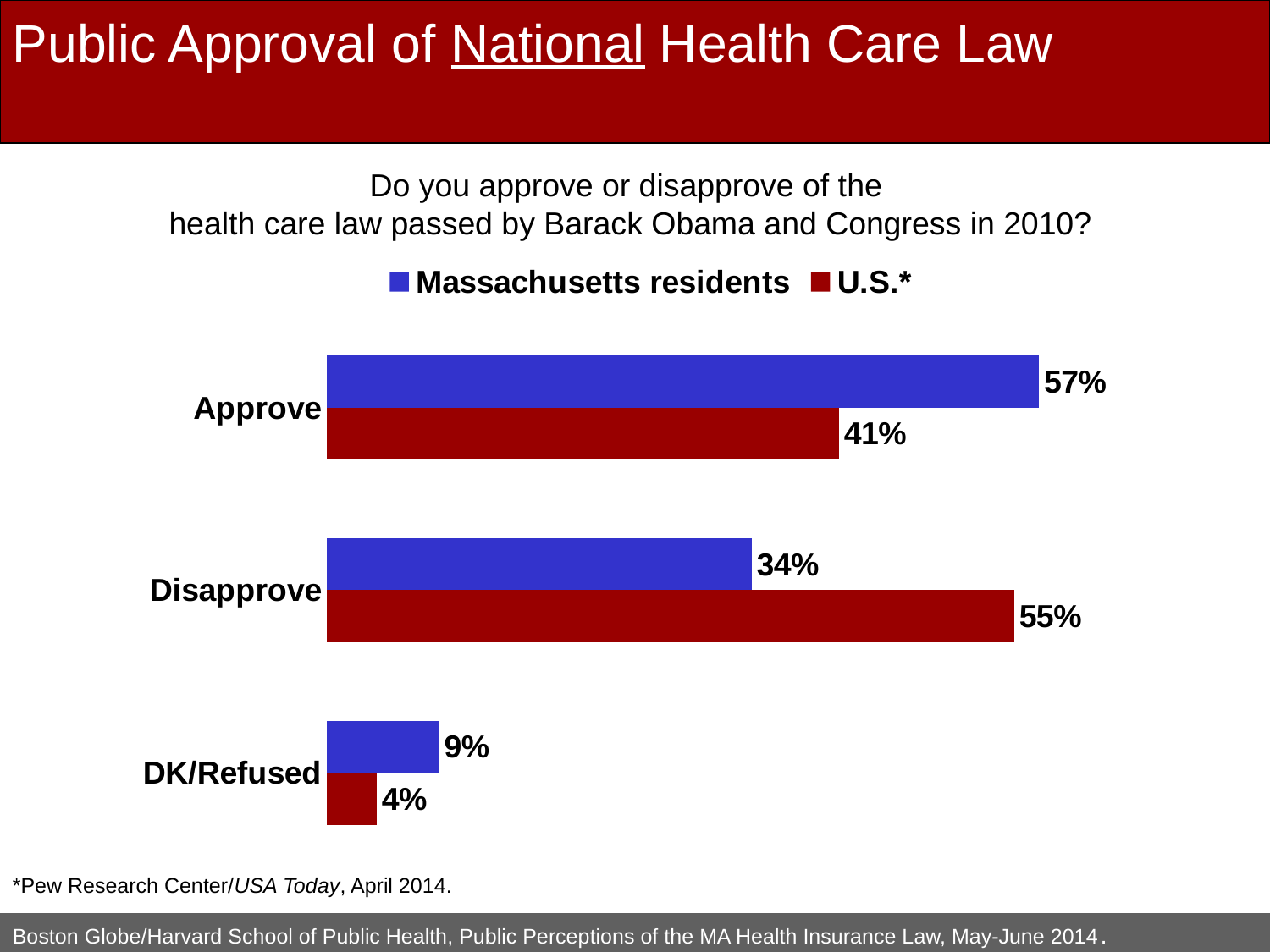
What is the DK/Refused value for Massachusetts residents? 9% What percentage of Massachusetts residents approve of the national health care law? 57% Which response category has the lowest value for the U.S.? DK/Refused Which response category has the highest value for Massachusetts residents? Approve What is the U.S. value for Approve? 41% What is the difference between the Massachusetts residents and U.S. values for Approve? 16 percentage points What kind of chart is shown on the slide? Bar chart What percentage of the U.S. disapproves of the national health care law? 55% Which is larger for Disapprove: Massachusetts residents or U.S.? U.S. What is the difference between the U.S. and Massachusetts residents values for Disapprove? 21 percentage points How many response categories are shown in the chart? 3 How many series does the legend list? 2